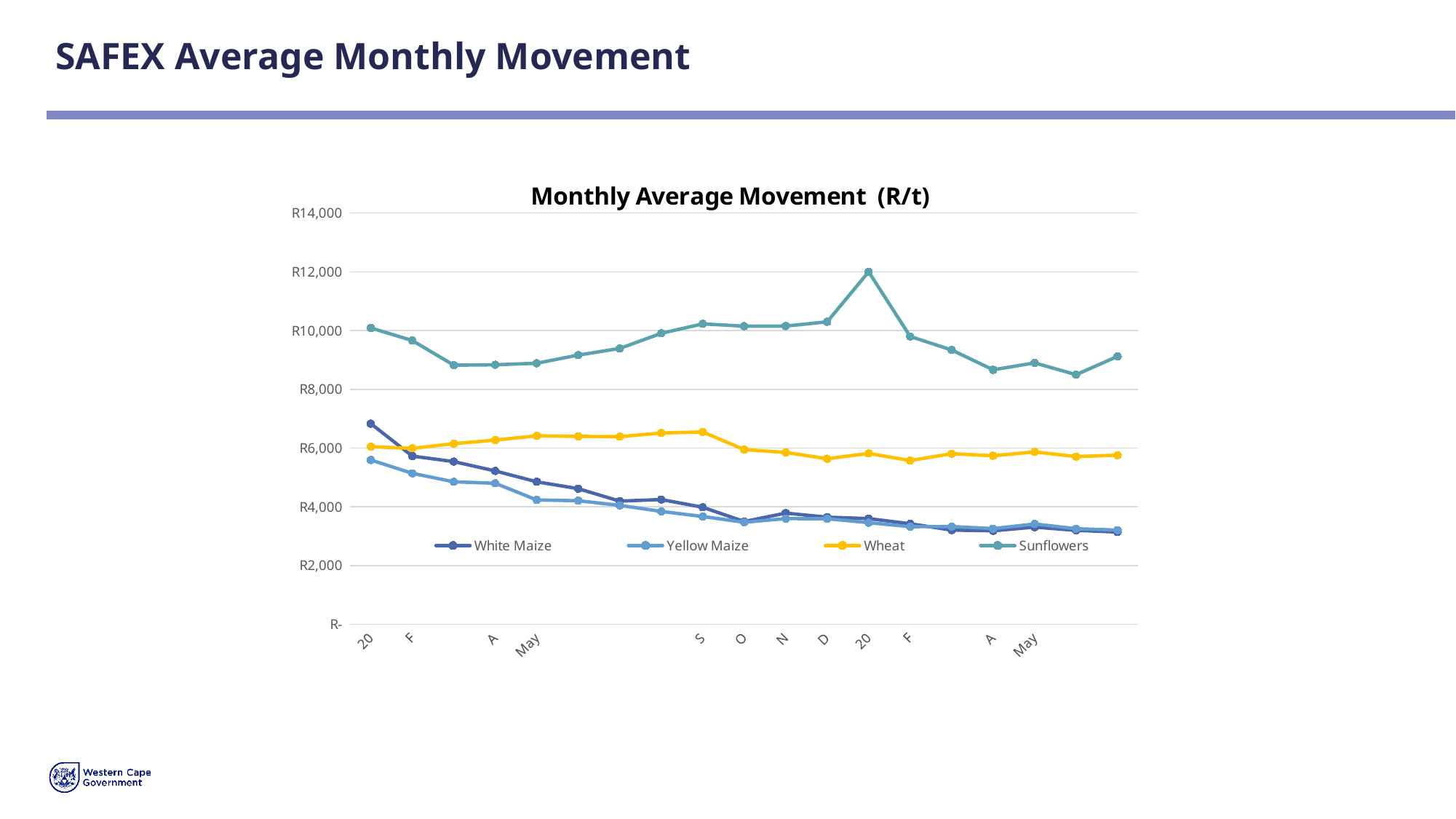
At the first point on the x axis, which is higher: White Maize or Yellow Maize? White Maize Is the last value of the White Maize series greater or less than R4,000? less Is the first value of the Wheat series greater or less than R8,000? less Which series is higher throughout the chart: Wheat or Sunflowers? Sunflowers Does the White Maize series generally rise or fall along the x axis? Fall How many series does the legend list? 4 Is the lowest value of the Sunflowers series greater or less than R8,000? greater What is the title of the chart? Monthly Average Movement (R/t) What kind of chart is shown on the slide? Line chart Which series are listed in the legend? White Maize, Yellow Maize, Wheat, Sunflowers Which series has the highest values across the whole chart? Sunflowers